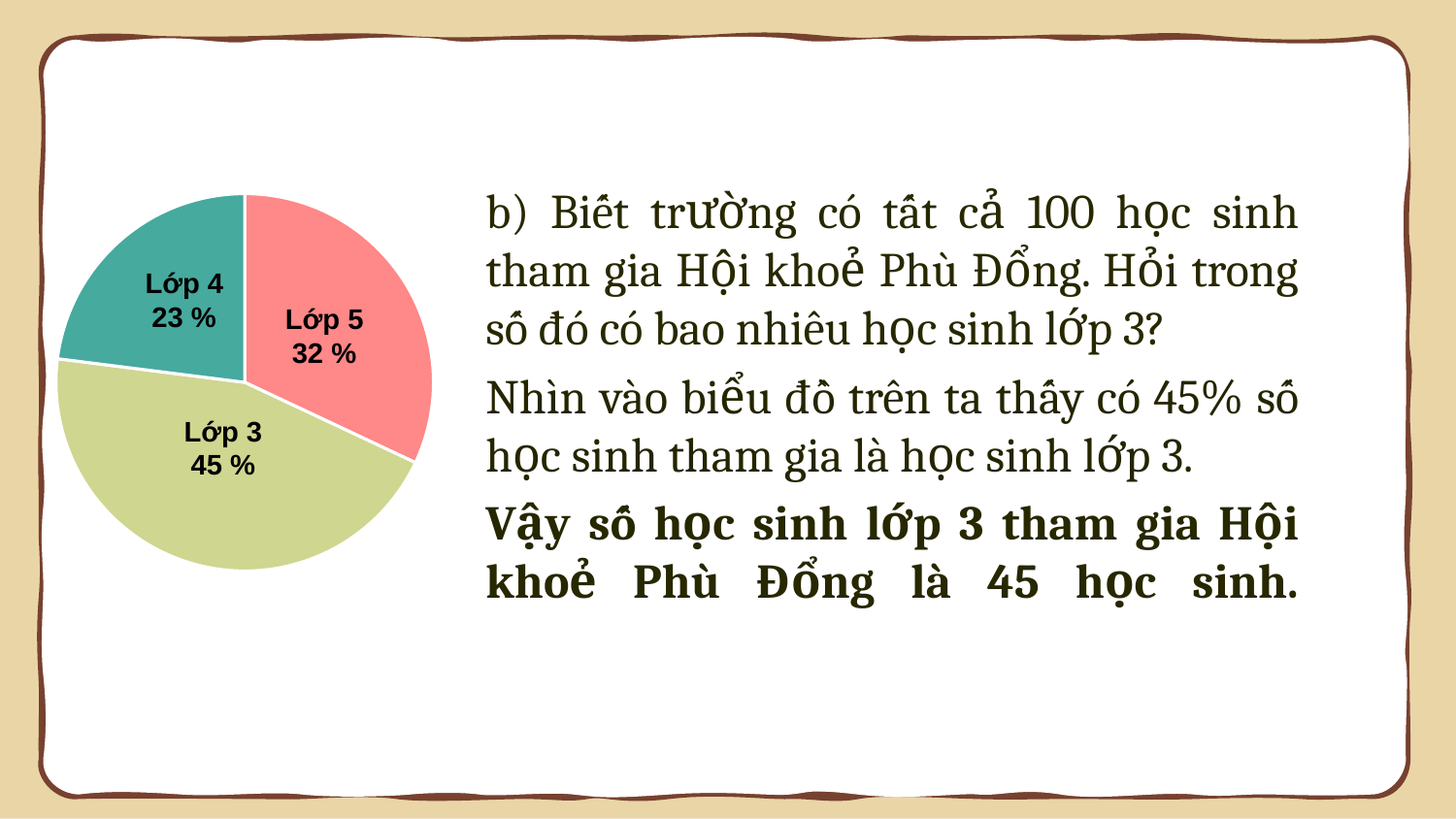
What colour is the Lớp 5 slice of the pie chart? pink How many slices does the pie chart have? 3 What is the difference in percentage points between Lớp 5 and Lớp 4? 9 Which slice is larger, Lớp 4 or Lớp 5? Lớp 5 What percentage of the pie chart is Lớp 5? 32 % Which class has the largest slice of the pie chart? Lớp 3 What colour is the Lớp 3 slice of the pie chart? light green What percentage of the pie chart is Lớp 4? 23 % What kind of chart is shown on the slide? pie chart What is the difference in percentage points between Lớp 3 and Lớp 5? 13 Which class has the smallest slice of the pie chart? Lớp 4 What percentage of the pie chart is Lớp 3? 45 %